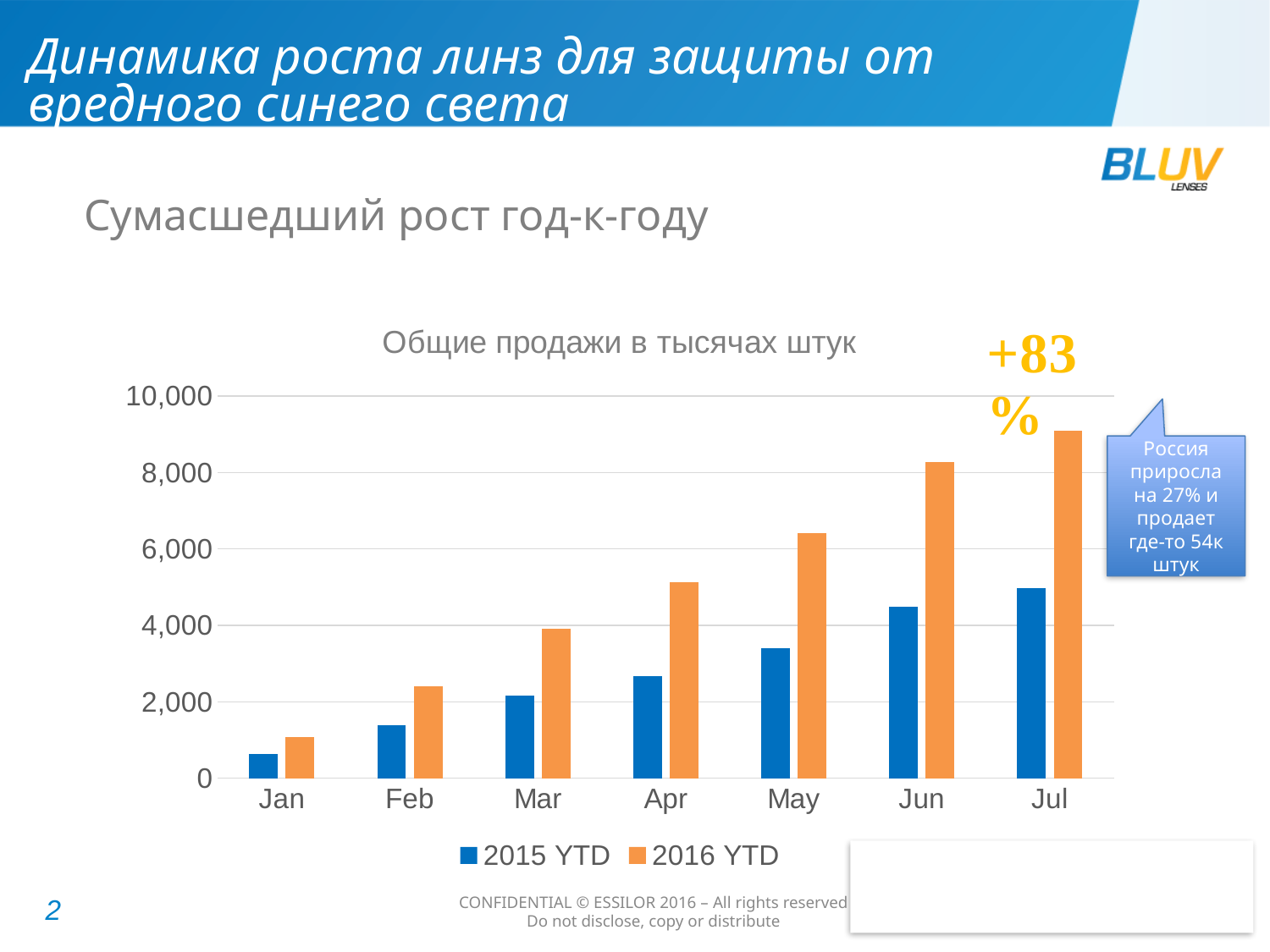
Is the 2016 YTD value for Jul greater or less than 8,000? greater Which colour represents the 2015 YTD series in the chart? blue What kind of chart is shown on the slide? bar chart How many months are shown on the x axis of the chart? 7 Is the 2015 YTD value for Mar greater or less than 4,000? less Is the 2016 YTD value for May greater or less than 6,000? greater Do the 2016 YTD values rise or fall from Jan to Jul? rise How many series does the chart legend list? 2 Which month has the highest 2016 YTD value? Jul What is the title of the chart? Общие продажи в тысячах штук Which month has the lowest 2015 YTD value? Jan In Jun, which series has the larger value, 2015 YTD or 2016 YTD? 2016 YTD